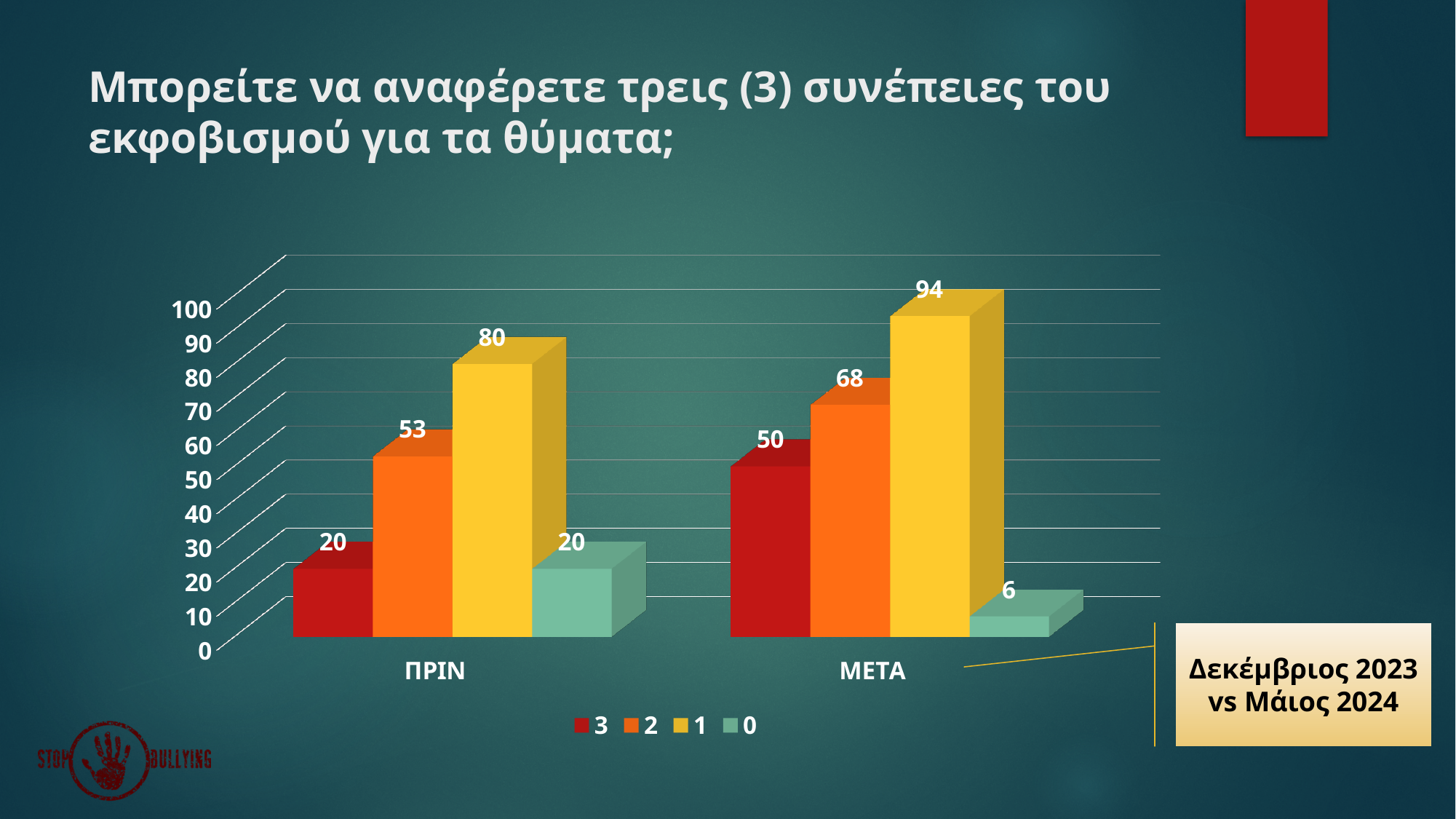
How many series does the legend list? 4 Which series has the lowest value in the ΜΕΤΑ category? 0 What is the value for series "0" in the ΜΕΤΑ category? 6 What is the value for series "2" in the ΠΡΙΝ category? 53 What is the value for series "3" in the ΜΕΤΑ category? 50 What is the value for series "1" in the ΠΡΙΝ category? 80 How many categories are shown on the x axis? 2 What is the difference between the value for series "1" in ΜΕΤΑ and in ΠΡΙΝ? 14 Which is larger: the value for series "2" in ΠΡΙΝ or in ΜΕΤΑ? ΜΕΤΑ What kind of chart is shown on the slide? Bar chart What colour represents series "3" in the chart? Dark red Which series has the highest value in the ΜΕΤΑ category? 1